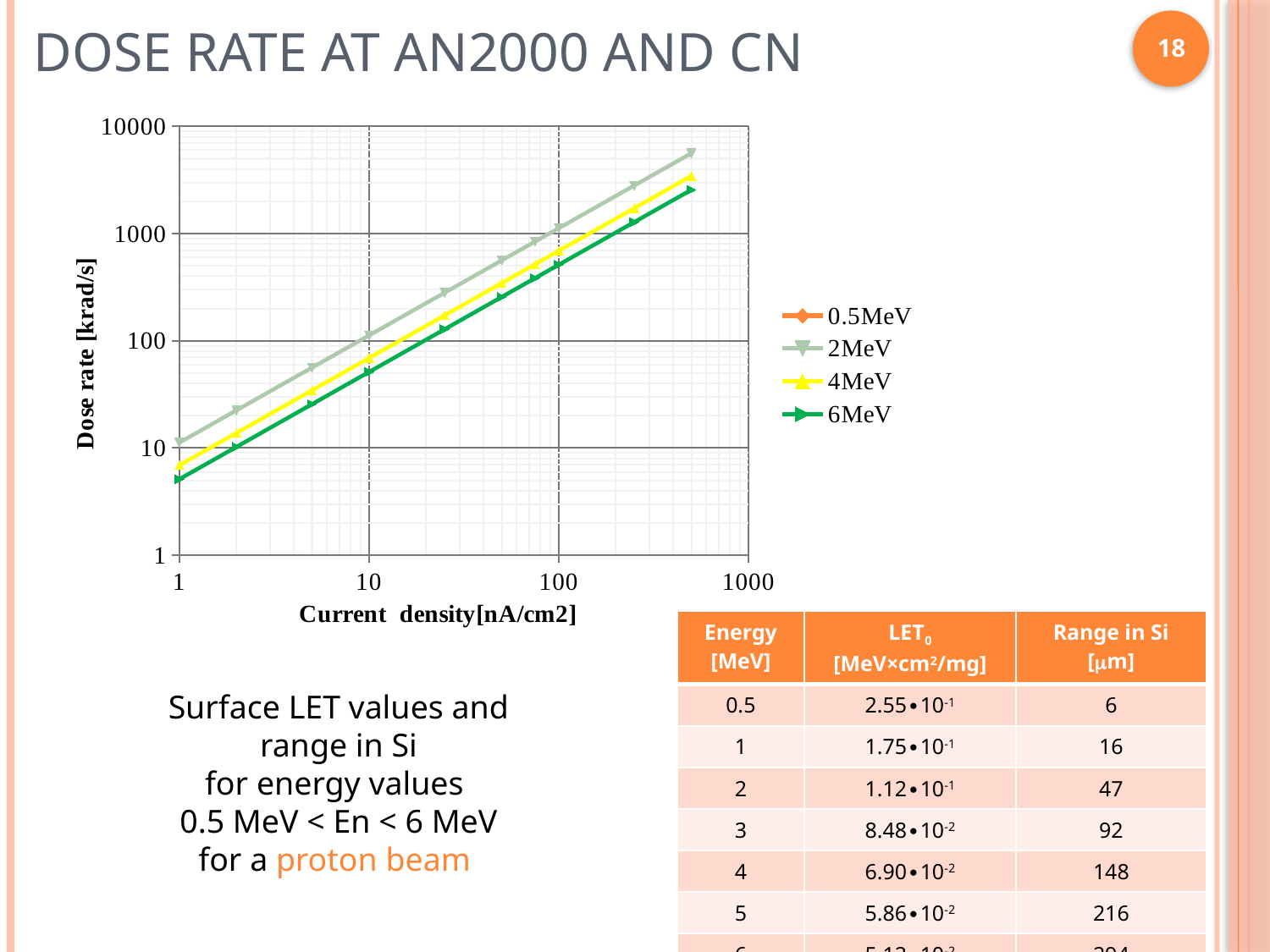
Is the dose rate for the 2MeV series at a current density of 10 nA/cm2 greater or less than 10 krad/s? greater Is the dose rate for the 4MeV series at a current density of 100 nA/cm2 greater or less than 1000 krad/s? less What is the title of the chart's y axis? Dose rate [krad/s] At a current density of 100 nA/cm2, which series has the higher dose rate, 2MeV or 6MeV? 2MeV At a current density of 10 nA/cm2, which series has the higher dose rate, 4MeV or 6MeV? 4MeV What is the title of the chart's x axis? Current density[nA/cm2] Is the dose rate for the 6MeV series at a current density of 100 nA/cm2 greater or less than 100 krad/s? greater Do the dose rate values rise or fall as current density increases along the x axis? rise How many series does the chart legend list? 4 What kind of chart is shown on the slide? line chart